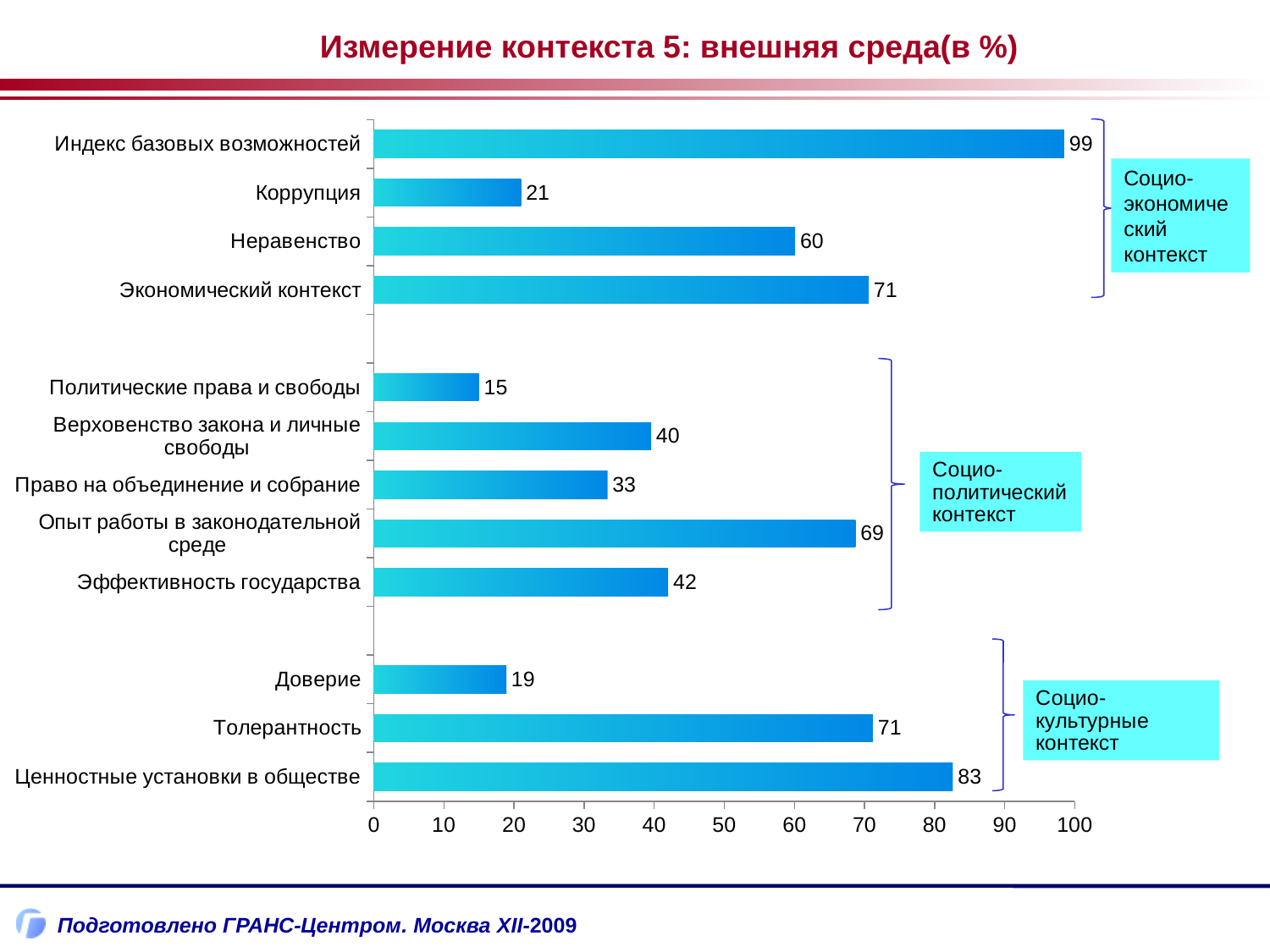
How many bars are plotted in the chart? 12 What is the value for Опыт работы в законодательной среде? 69 Which category has the lowest value? Политические права и свободы Which category has the highest value? Индекс базовых возможностей What is the title of the chart? Измерение контекста 5: внешняя среда(в %) What kind of chart is shown on the slide? bar chart What is the difference between the values for Ценностные установки в обществе and Толерантность? 12 What is the value for Индекс базовых возможностей? 99 Which is larger, the value for Неравенство or the value for Эффективность государства? Неравенство What is the value for Доверие? 19 Is the value for Право на объединение и собрание greater or less than 40? less What is the value for Коррупция? 21